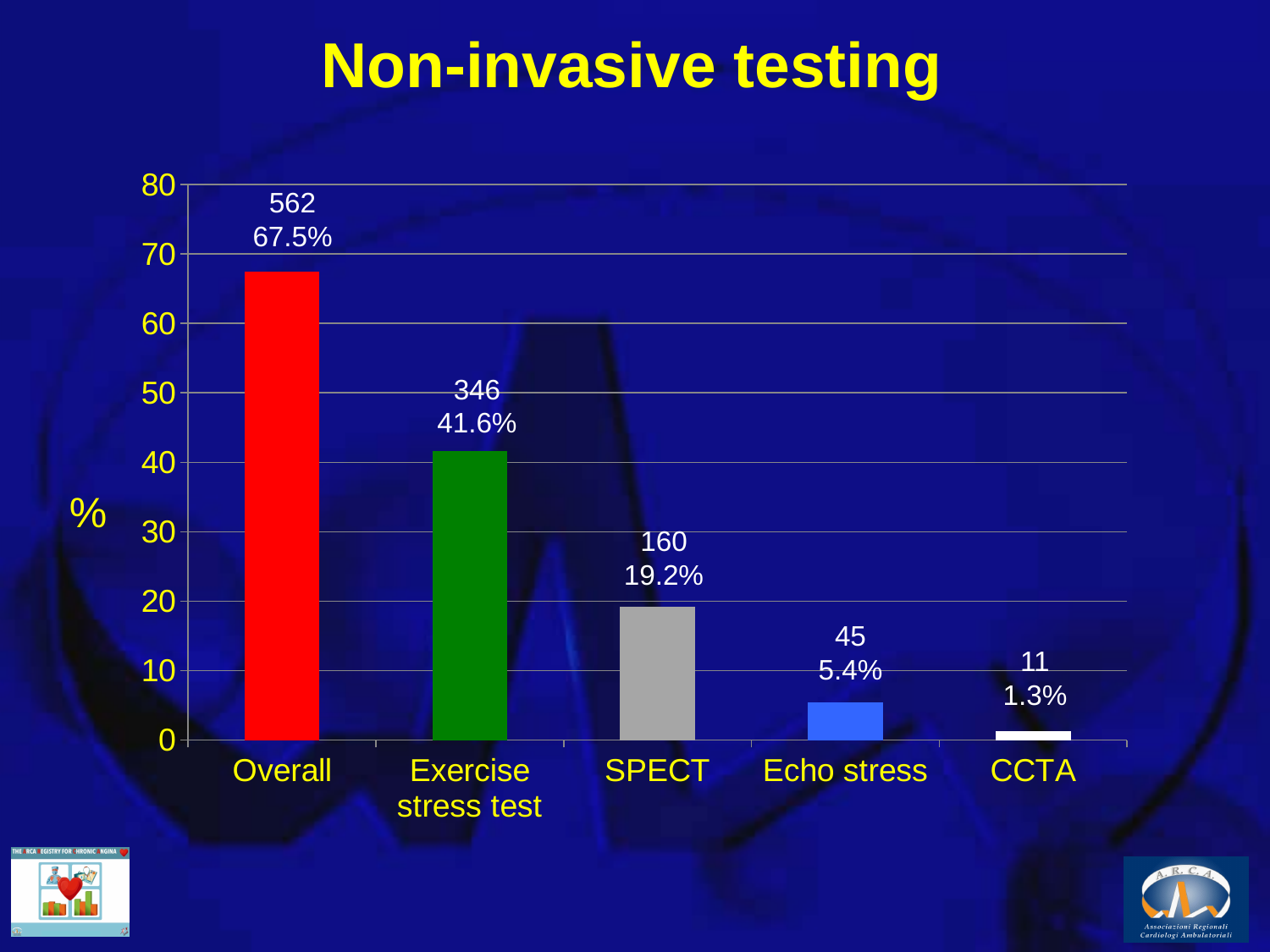
What count is shown above the SPECT bar? 160 What is the title of the chart? Non-invasive testing Which category has the lowest value? CCTA What percentage is shown for Echo stress? 5.4% Which is larger, the value for SPECT or the value for Echo stress? SPECT What is the difference in percentage points between Overall and Exercise stress test? 25.9 Is the value for Exercise stress test greater or less than 40? greater Which category has the highest value? Overall What count is shown above the CCTA bar? 11 What kind of chart is shown on the slide? Bar chart What percentage is shown for Exercise stress test? 41.6% How many categories are shown on the x axis? 5